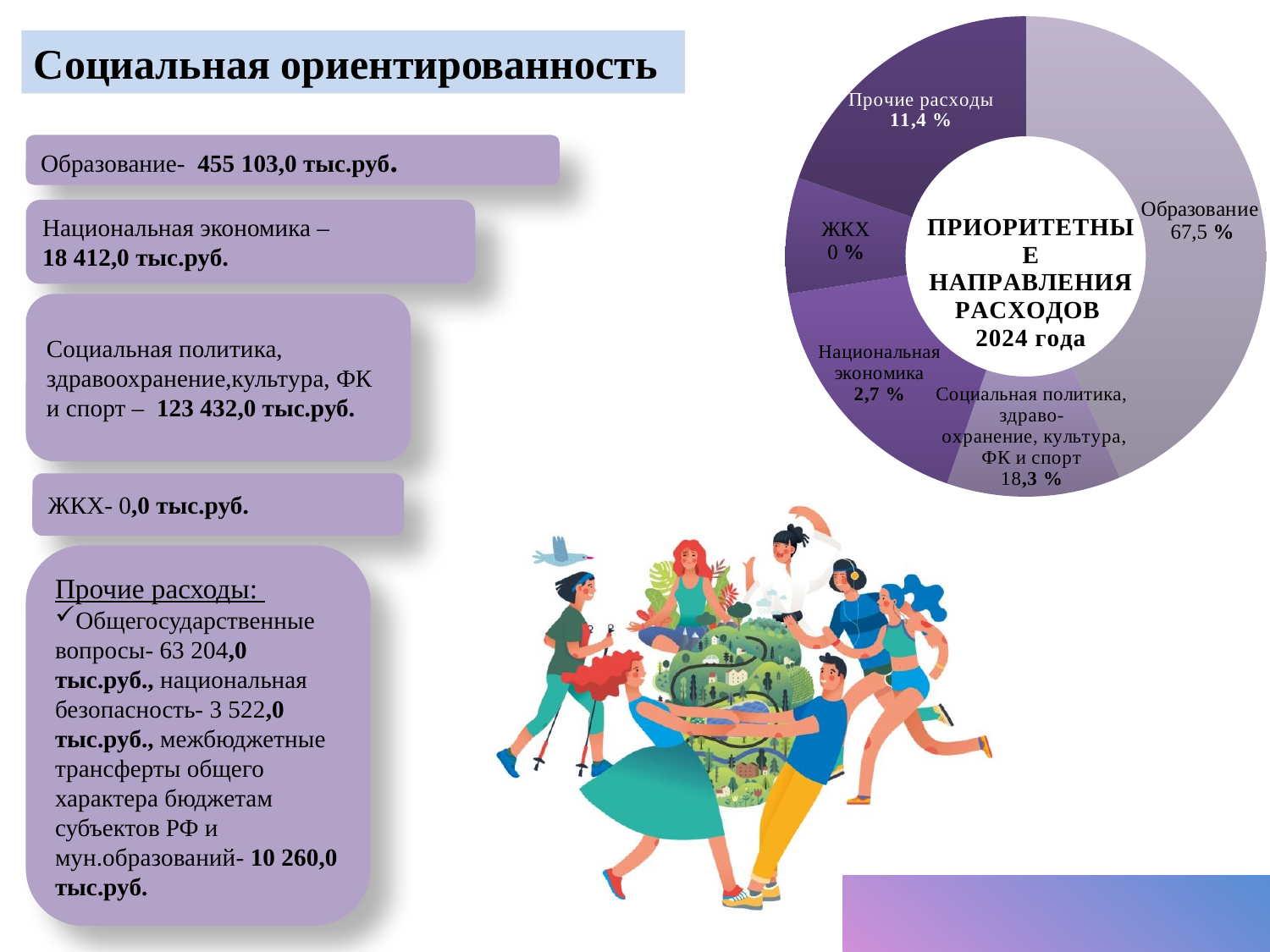
How many categories are shown in the pie chart? 5 What percentage is shown for Прочие расходы in the pie chart? 11,4 % What share is shown for Национальная экономика in the pie chart? 2,7 % What percentage does the pie chart show for ЖКХ? 0 % What share of the pie chart does Образование account for? 67,5 % Which has a larger share in the pie chart: Прочие расходы or Национальная экономика? Прочие расходы Which category has the largest share in the pie chart? Образование Which category has the smallest share in the pie chart? ЖКХ What type of chart is shown on the slide? Pie (doughnut) chart What is the title shown in the centre of the pie chart? ПРИОРИТЕТНЫЕ НАПРАВЛЕНИЯ РАСХОДОВ 2024 года What share is shown for Социальная политика, здравоохранение, культура, ФК и спорт in the pie chart? 18,3 % What is the difference in percentage points between Образование and Прочие расходы in the pie chart? 56,1